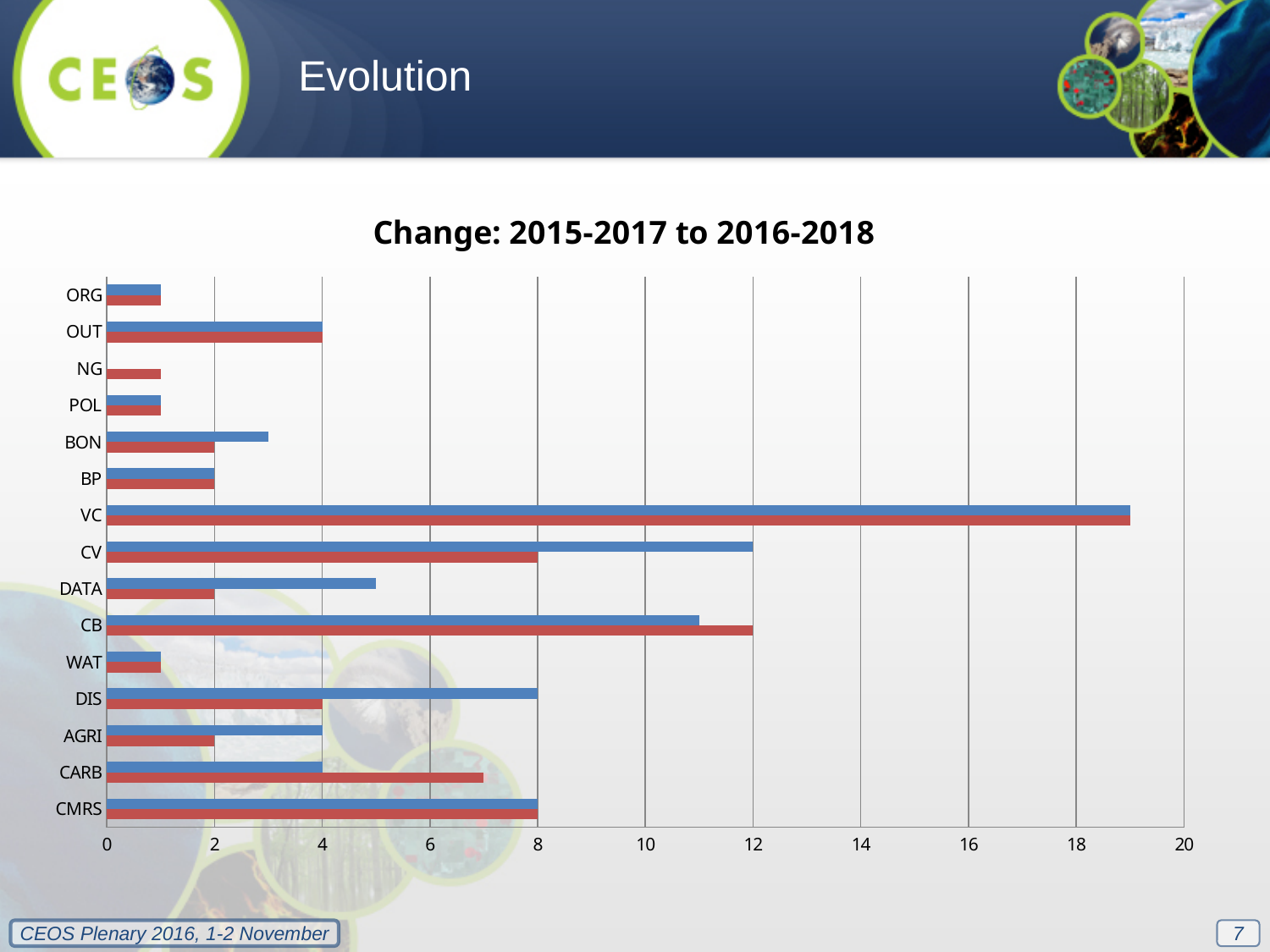
What is the value of the blue bar for DIS? 8 Is the value of the blue bar for DATA greater or less than 4? greater For DIS, which bar is longer, the blue bar or the red bar? The blue bar What is the value of the red bar for CMRS? 8 What is the value of the blue bar for CV? 12 What is the difference between the blue bar and the red bar for CV? 4 What type of chart is shown on the slide? Bar chart What is the value of the red bar for CB? 12 How many categories are shown on the vertical axis of the chart? 15 What is the title of the chart? Change: 2015-2017 to 2016-2018 Is the value of the blue bar for VC greater or less than 18? greater Which category has the longest blue bar? VC